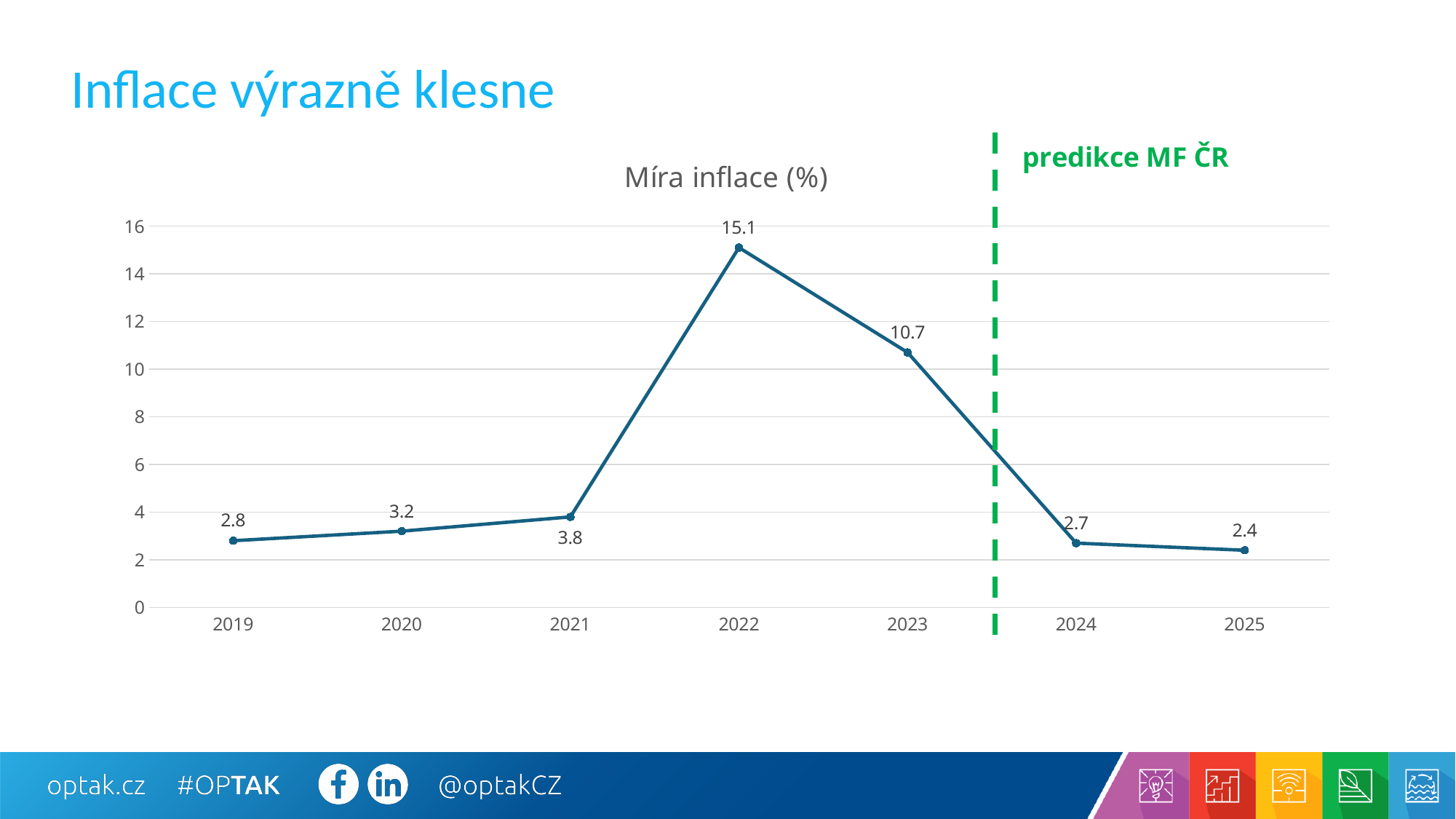
Which year has the highest inflation rate on the chart? 2022 What is the difference between the inflation rate in 2022 and in 2023? 4.4 Do the values rise or fall from 2023 to 2025? fall What is the inflation rate shown for 2019? 2.8 What is the title of the chart? Míra inflace (%) Is the value for 2023 greater or less than 10? greater How many years are plotted on the chart? 7 What is the inflation rate shown for 2022? 15.1 What is the predicted inflation rate for 2025? 2.4 Which year has the lowest inflation rate on the chart? 2025 Which year has a higher inflation rate, 2021 or 2024? 2021 What kind of chart is shown on the slide? line chart